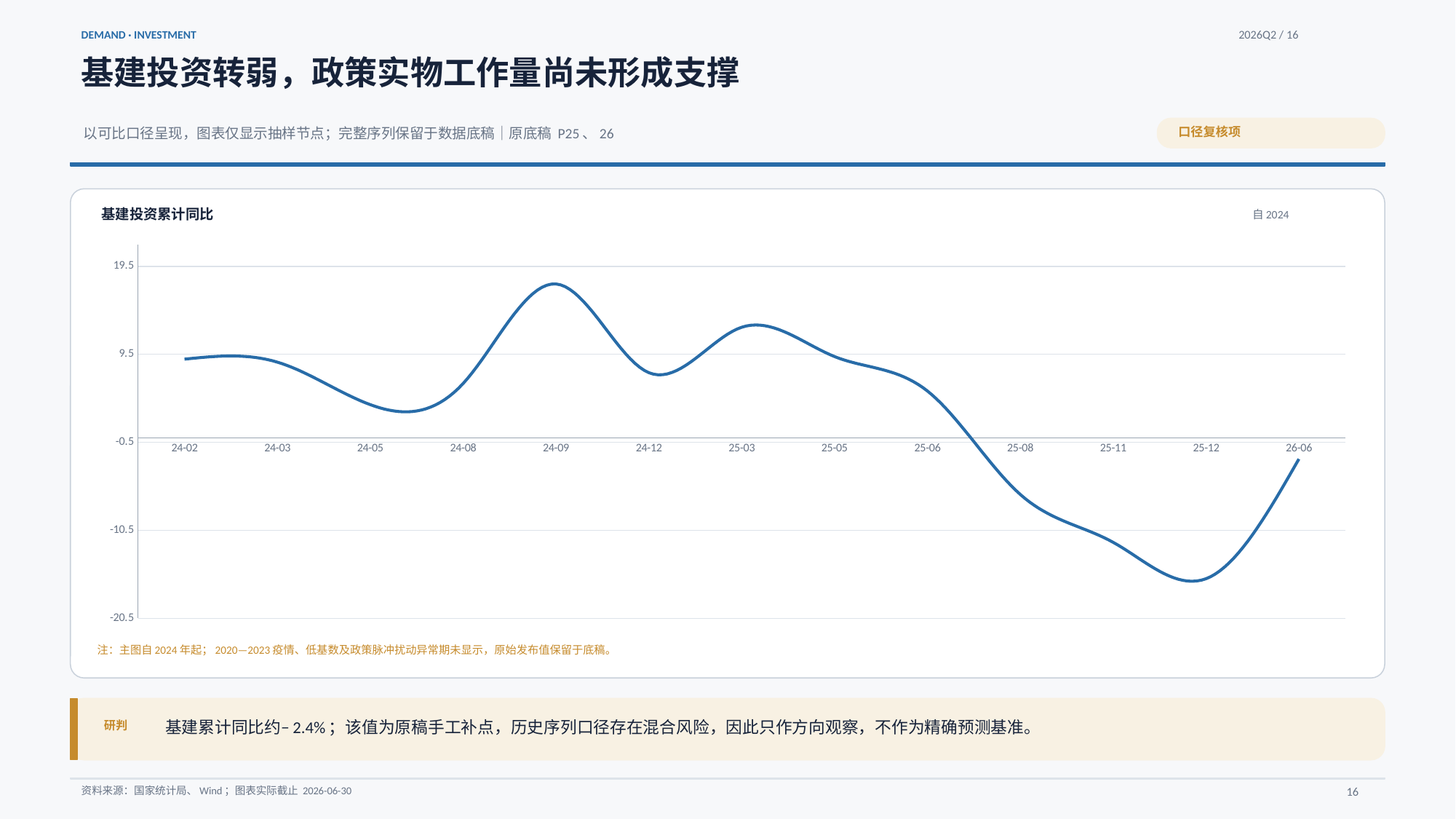
Which x-axis point has the highest value on the line? 24-09 Is the value at 25-12 greater or less than -10.5? less What kind of chart is shown on the slide? line chart Which is larger, the value at 24-09 or the value at 25-03? 24-09 Overall, does the line rise or fall from 24-02 to 26-06? fall Is the value at 24-09 greater or less than 9.5? greater Is the value at 25-08 greater or less than -0.5? less What is the title of the chart? 基建投资累计同比 Which is larger, the value at 24-02 or the value at 24-05? 24-02 How many points are labelled on the x axis of the chart? 13 Which x-axis point has the lowest value on the line? 25-12